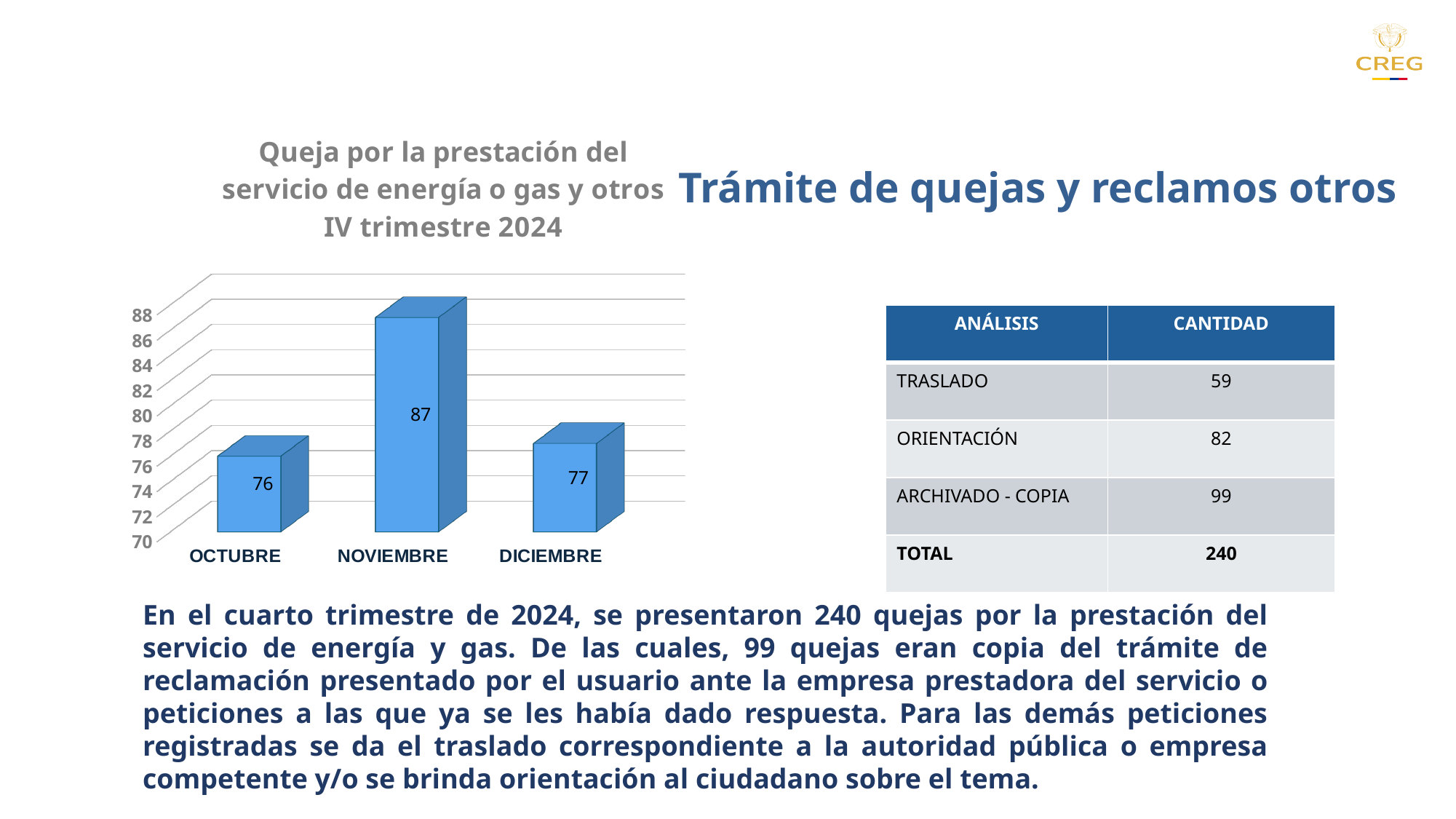
What is the title of the chart? Queja por la prestación del servicio de energía o gas y otros IV trimestre 2024 Which month has the highest value in the chart? NOVIEMBRE What is the difference between the values for DICIEMBRE and OCTUBRE? 1 What kind of chart is shown on the slide? bar chart Is the value for NOVIEMBRE greater or less than 80? greater Which month has the lowest value in the chart? OCTUBRE Which is larger, the value for NOVIEMBRE or the value for DICIEMBRE? NOVIEMBRE What is the difference between the values for NOVIEMBRE and OCTUBRE? 11 What is the value for NOVIEMBRE in the chart? 87 What is the value for DICIEMBRE in the chart? 77 How many months are shown in the chart? 3 What is the value for OCTUBRE in the chart? 76